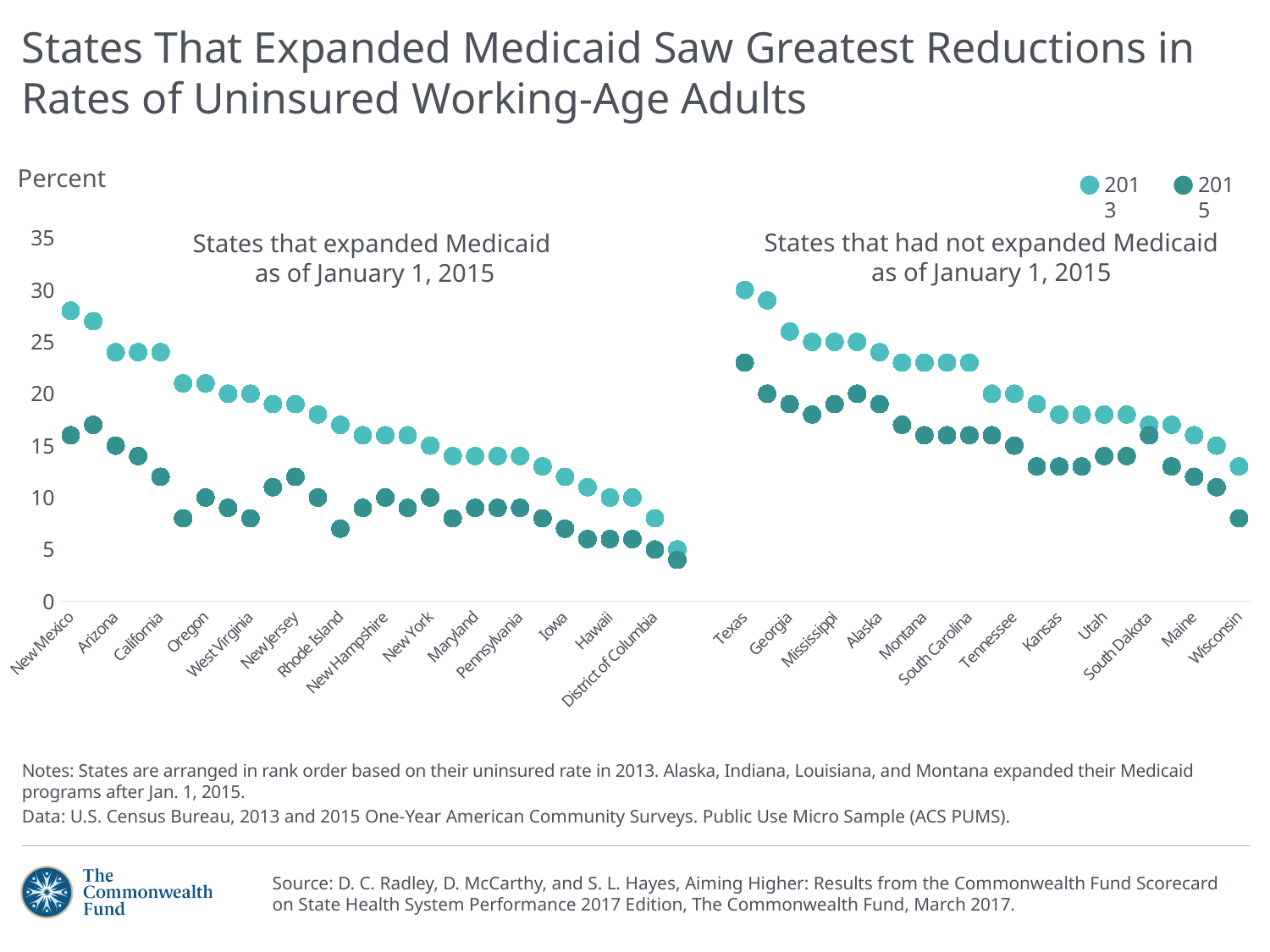
Is the 2015 value for Wisconsin greater or less than 10? less Is the 2015 value for Texas greater or less than 20? greater Which is larger, the 2015 value for Texas or the 2015 value for New Mexico? Texas Do the 2013 values rise or fall from left to right within each group of states? fall What years are listed in the chart legend? 2013 and 2015 Is the 2013 value for Texas greater or less than 25? greater Among the states that had not expanded Medicaid, which state has the highest 2013 uninsured rate? Texas What is the label on the vertical axis of the chart? Percent Among the states that expanded Medicaid, which state has the highest 2013 uninsured rate? New Mexico How many series does the legend list? 2 What kind of chart is shown on the slide? Scatter (dot) chart